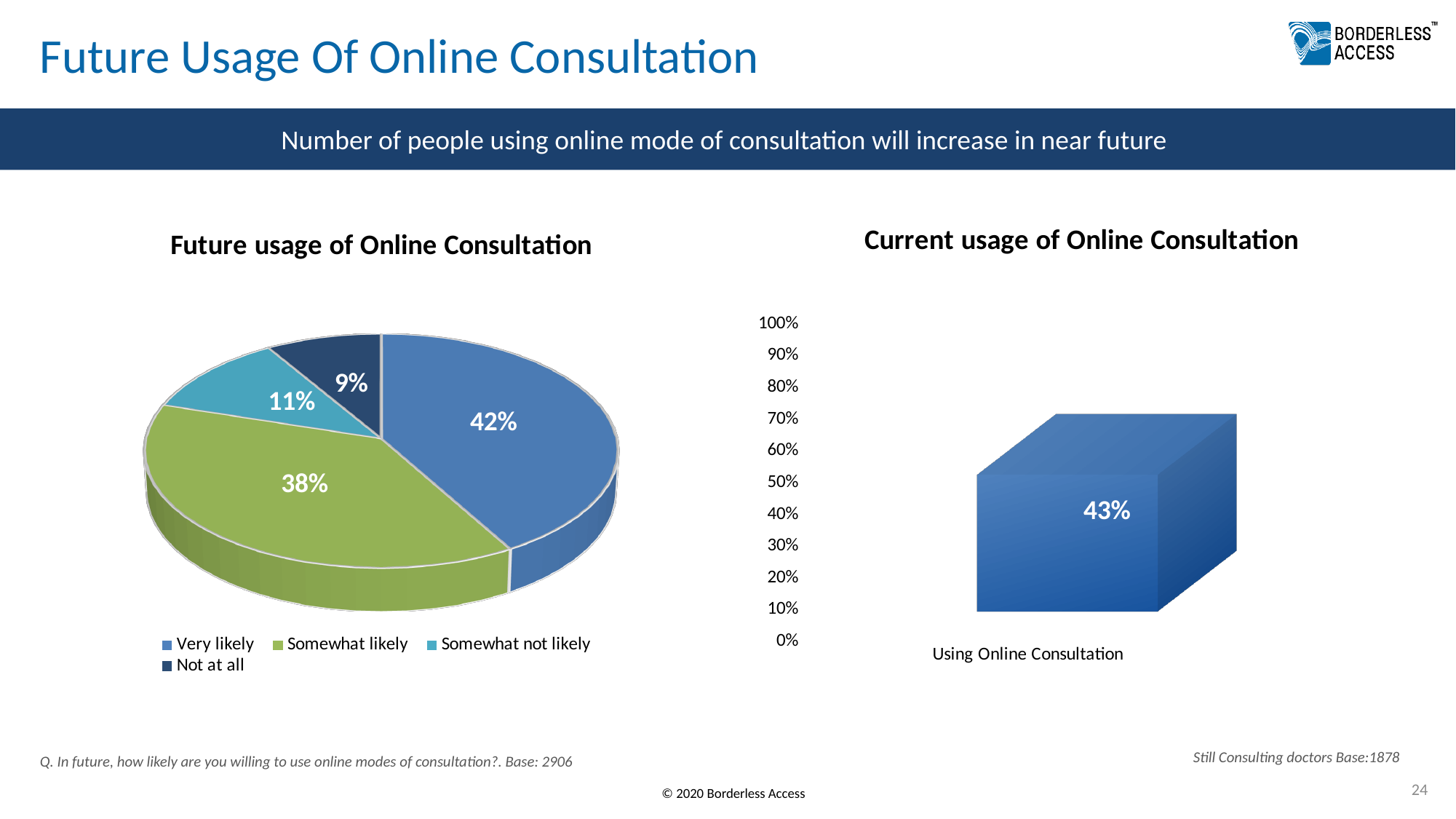
In the 'Future usage of Online Consultation' pie chart, what share is labelled for 'Not at all'? 9% In the 'Current usage of Online Consultation' chart, what value is labelled for 'Using Online Consultation'? 43% How many categories does the legend of the 'Future usage of Online Consultation' pie chart list? 4 What kind of chart is 'Future usage of Online Consultation'? Pie chart What kind of chart is 'Current usage of Online Consultation'? Bar chart In the 'Future usage of Online Consultation' pie chart, what share is labelled for 'Very likely'? 42% In the 'Current usage of Online Consultation' chart, is the value for 'Using Online Consultation' greater or less than 50%? less In the 'Future usage of Online Consultation' pie chart, which category has the smallest slice? Not at all In the 'Future usage of Online Consultation' pie chart, which category has the largest slice? Very likely In the 'Future usage of Online Consultation' pie chart, what share is labelled for 'Somewhat likely'? 38% In the 'Future usage of Online Consultation' pie chart, what is the difference between the 'Very likely' and 'Somewhat likely' shares? 4% In the 'Future usage of Online Consultation' pie chart, which is larger: 'Somewhat not likely' or 'Not at all'? Somewhat not likely